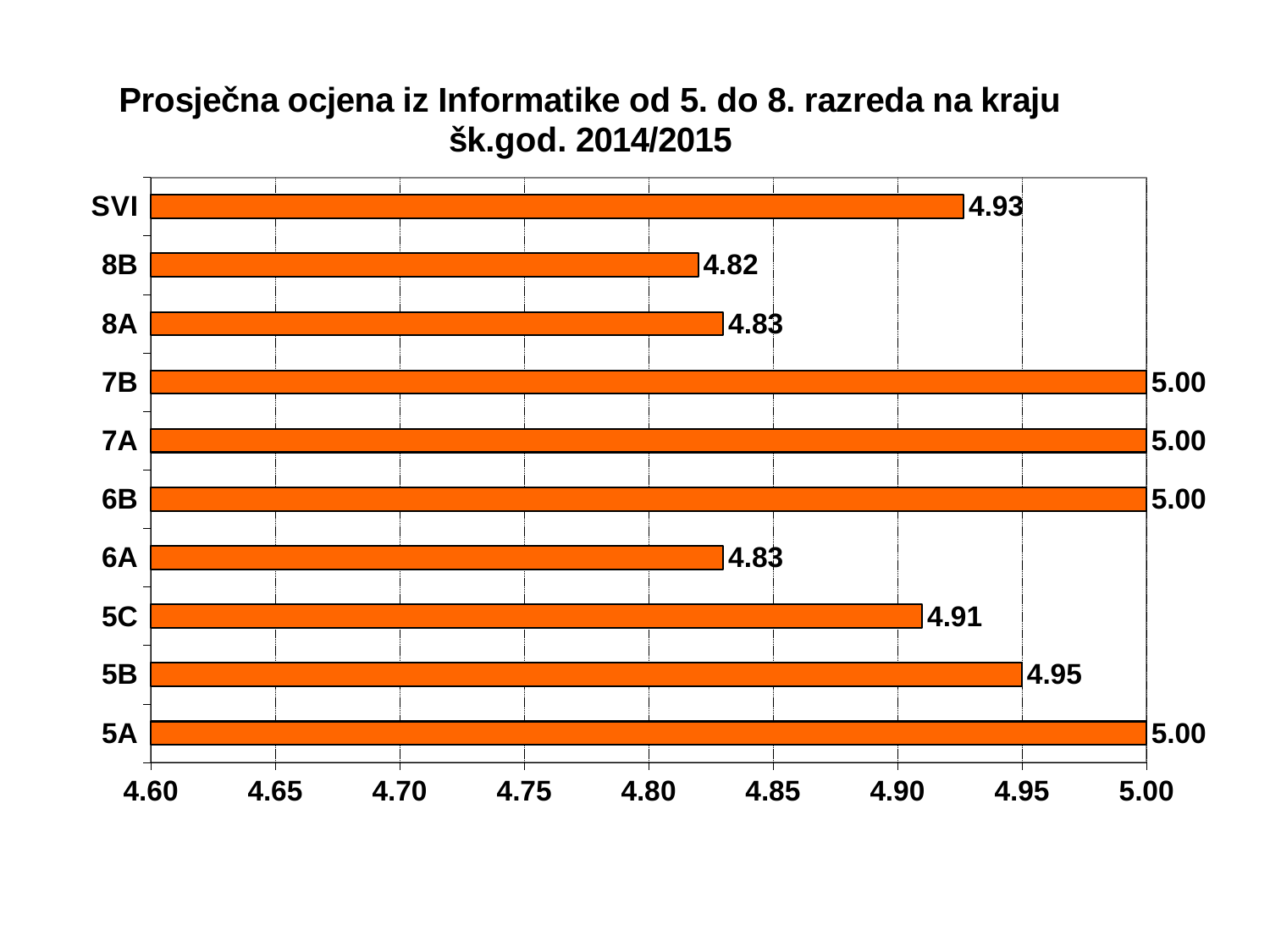
What is the difference between the values for SVI and 8A? 0.10 Which is larger, the value for 5C or the value for 6A? 5C What is the value shown for SVI? 4.93 What is the difference between the values for 5B and 5C? 0.04 What is the average grade for class 8B? 4.82 What is the average grade for class 5B? 4.95 What kind of chart is shown on the slide? bar chart How many classes have an average grade of 5.00? 4 What is the lowest value shown on the horizontal axis? 4.60 Which class has the lowest average grade? 8B How many categories are shown on the chart? 10 Is the value for 8A greater or less than 4.90? less